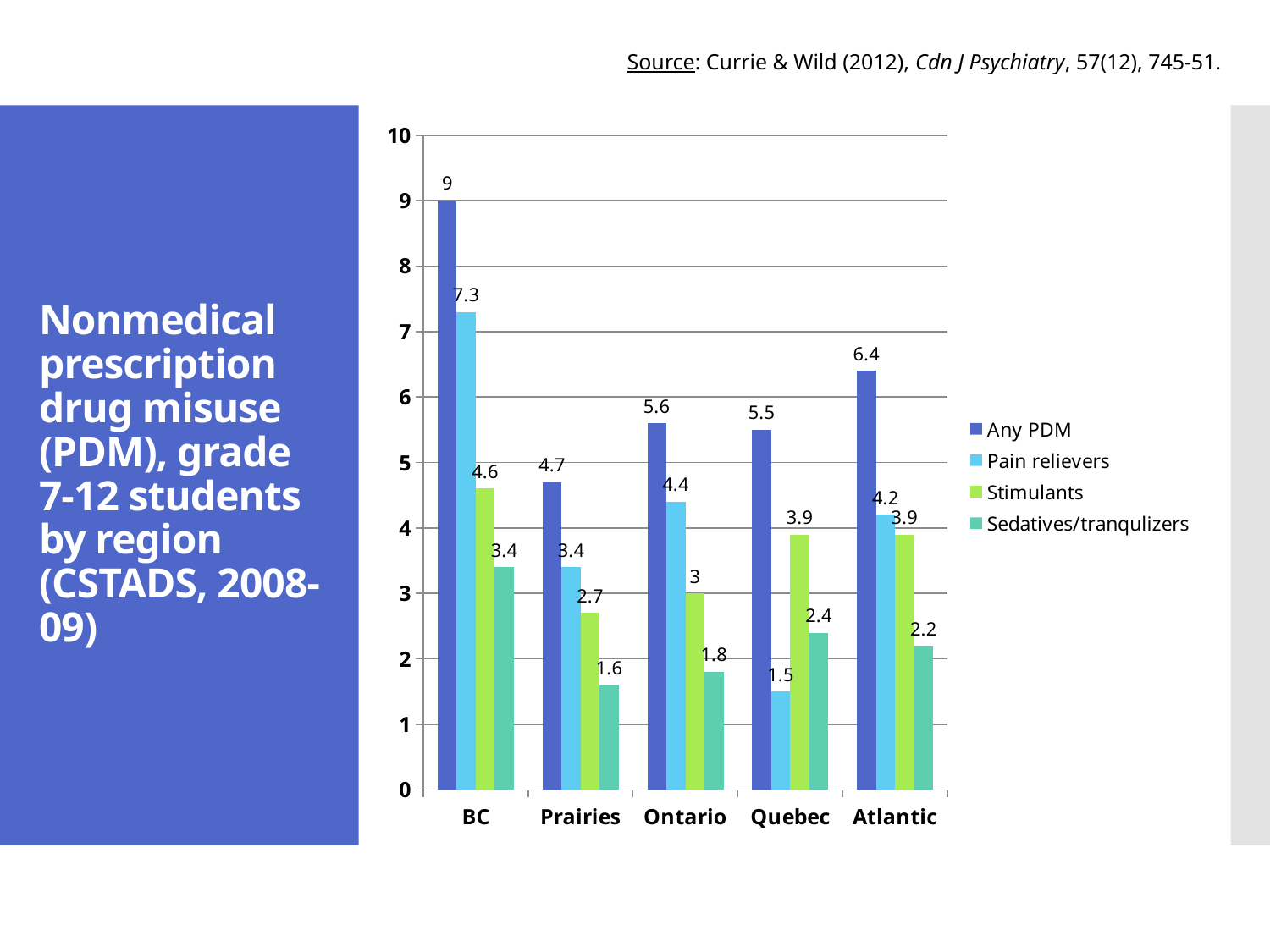
Which region has the highest value for Any PDM? BC Which is larger, the Stimulants value for Quebec or the Stimulants value for Prairies? Quebec What is the difference between the Any PDM values for BC and Atlantic? 2.6 What is the value for Pain relievers in Quebec? 1.5 How many series does the legend list? 4 How many regions are shown on the x axis? 5 Which series is shown in dark blue in the legend? Any PDM What is the value for Any PDM in BC? 9 What is the value for Sedatives/tranqulizers in Atlantic? 2.2 What is the value for Stimulants in Ontario? 3 Which region has the lowest value for Pain relievers? Quebec What kind of chart is shown on the slide? bar chart